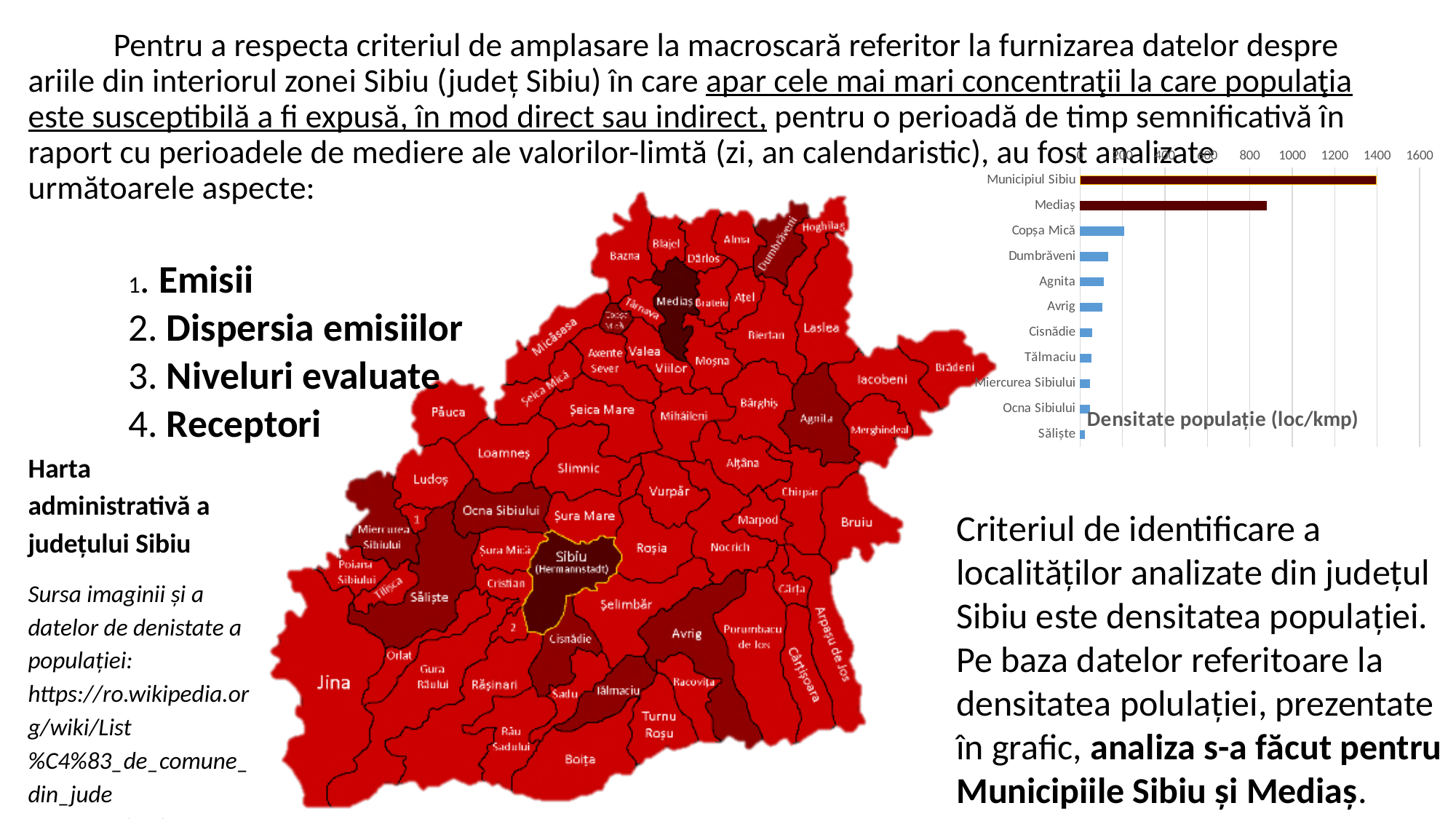
Is the value for Săliște greater or less than 200? less Is the value for Mediaș greater or less than 800? greater What is the title of the chart on the slide? Densitate populație (loc/kmp) Which has a higher population density, Mediaș or Copșa Mică? Mediaș What kind of chart is shown on the slide? bar chart How many localities are listed in the chart? 11 Is the value for Mediaș greater or less than 1000? less Which locality has the lowest population density in the chart? Săliște Which locality has the highest population density in the chart? Municipiul Sibiu Do the bar values increase or decrease going from the top category to the bottom category? decrease